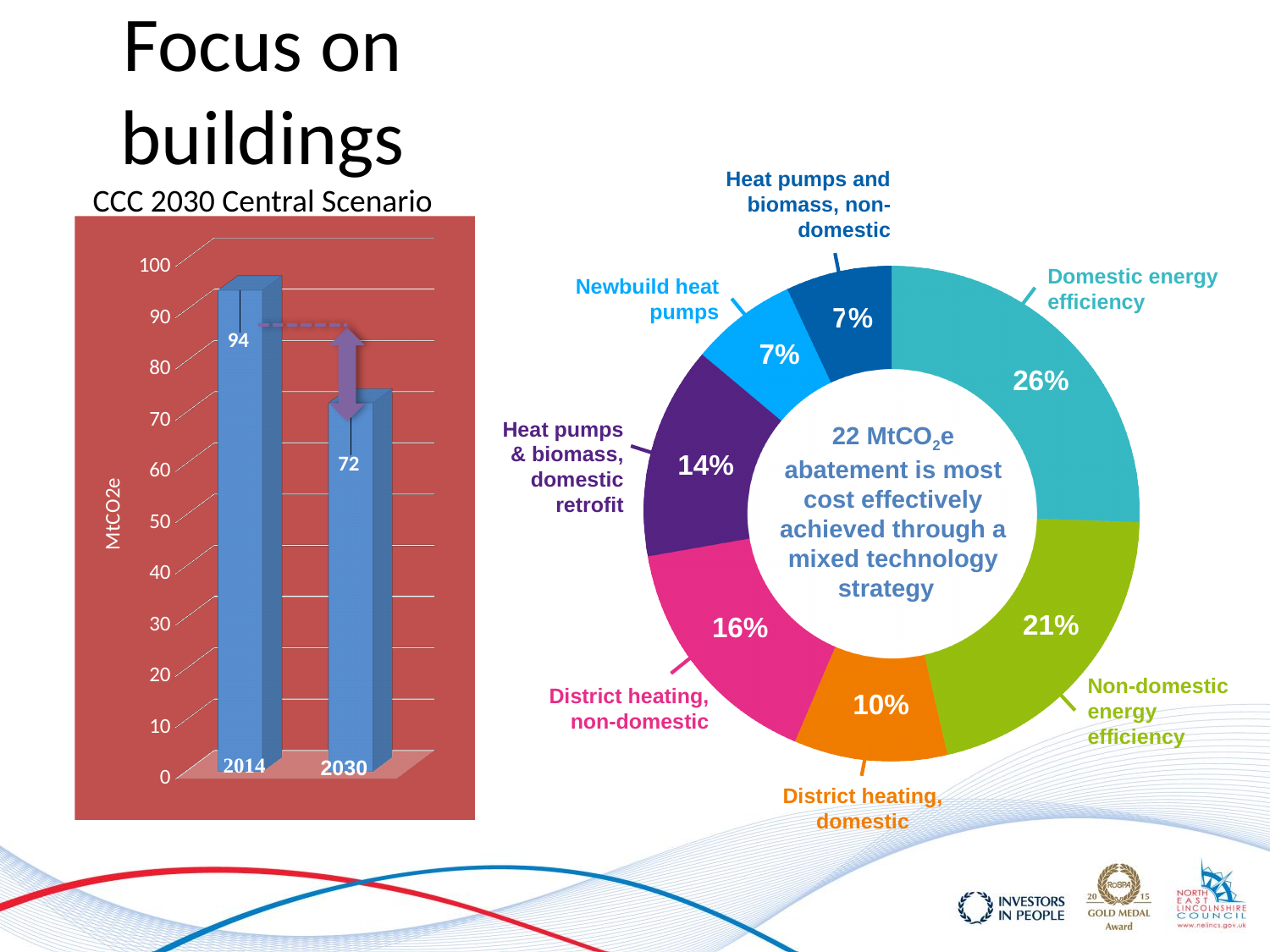
In the CCC 2030 Central Scenario bar chart, what is the difference between the 2014 and 2030 values? 22 In the CCC 2030 Central Scenario bar chart, do the values rise or fall from 2014 to 2030? fall What kind of chart is the CCC 2030 Central Scenario chart on the left? bar chart In the CCC 2030 Central Scenario bar chart, what is the value for 2014? 94 In the donut chart on the right, what is the difference between the shares for Domestic energy efficiency and District heating, domestic? 16% In the donut chart on the right, how many segments are there? 7 In the donut chart on the right, which segment has the largest share? Domestic energy efficiency In the donut chart on the right, what share is Domestic energy efficiency? 26% In the CCC 2030 Central Scenario bar chart, what is the value for 2030? 72 In the donut chart on the right, which is larger: Non-domestic energy efficiency or Heat pumps & biomass, domestic retrofit? Non-domestic energy efficiency In the CCC 2030 Central Scenario bar chart, what unit is shown on the vertical axis? MtCO2e In the donut chart on the right, what share is District heating, non-domestic? 16%